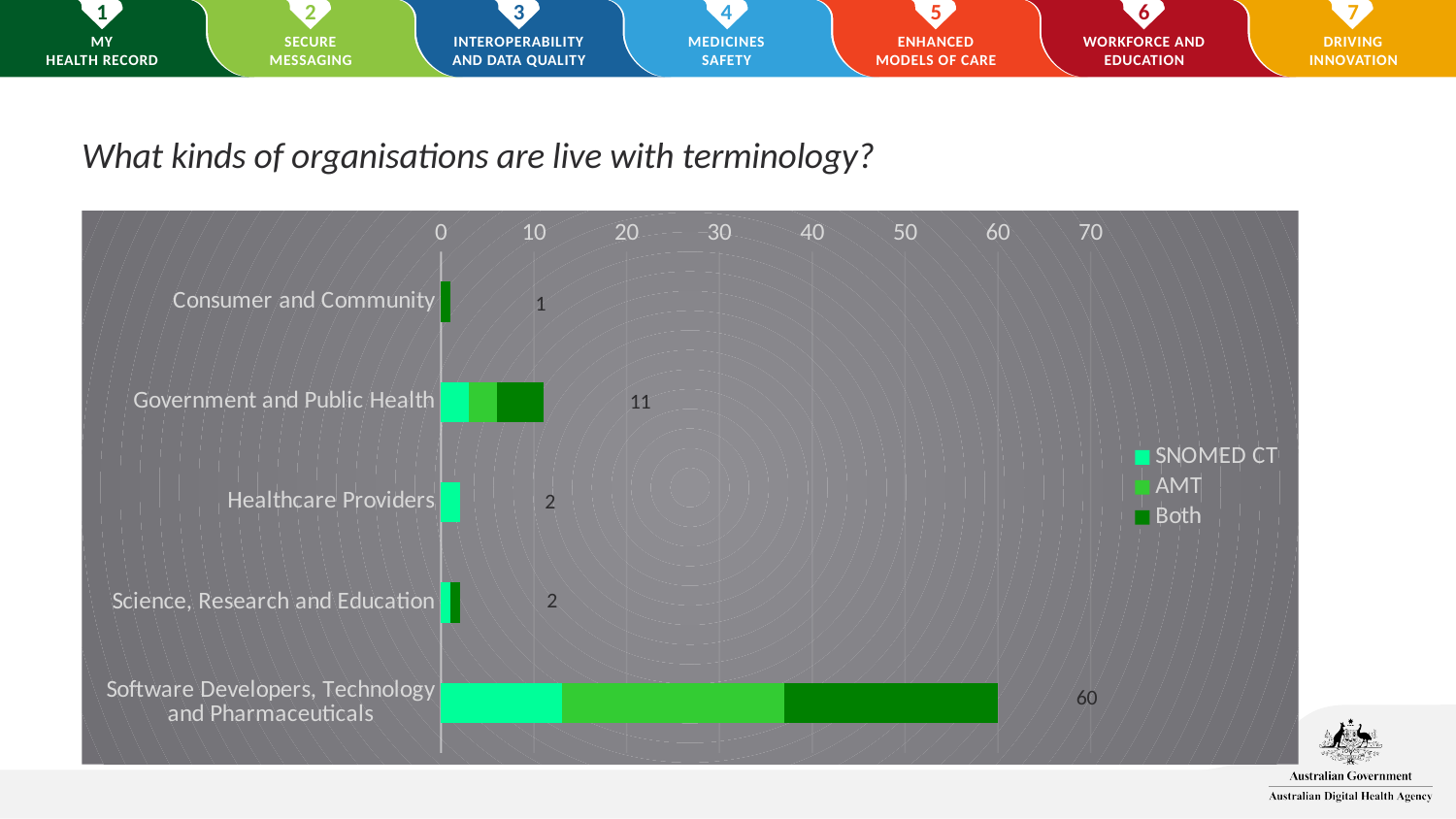
What is the total value shown for Software Developers, Technology and Pharmaceuticals? 60 What is the total value shown for Consumer and Community? 1 What is the total value shown for Government and Public Health? 11 Is the total for Software Developers, Technology and Pharmaceuticals greater or less than 50? greater How many categories are shown on the chart? 5 What is the total value shown for Healthcare Providers? 2 Which category has the lowest total? Consumer and Community Which has a larger total, Government and Public Health or Healthcare Providers? Government and Public Health Which category has the highest total? Software Developers, Technology and Pharmaceuticals What kind of chart is shown on the slide? Stacked bar chart What is the difference between the totals for Software Developers, Technology and Pharmaceuticals and Government and Public Health? 49 How many series does the legend list? 3